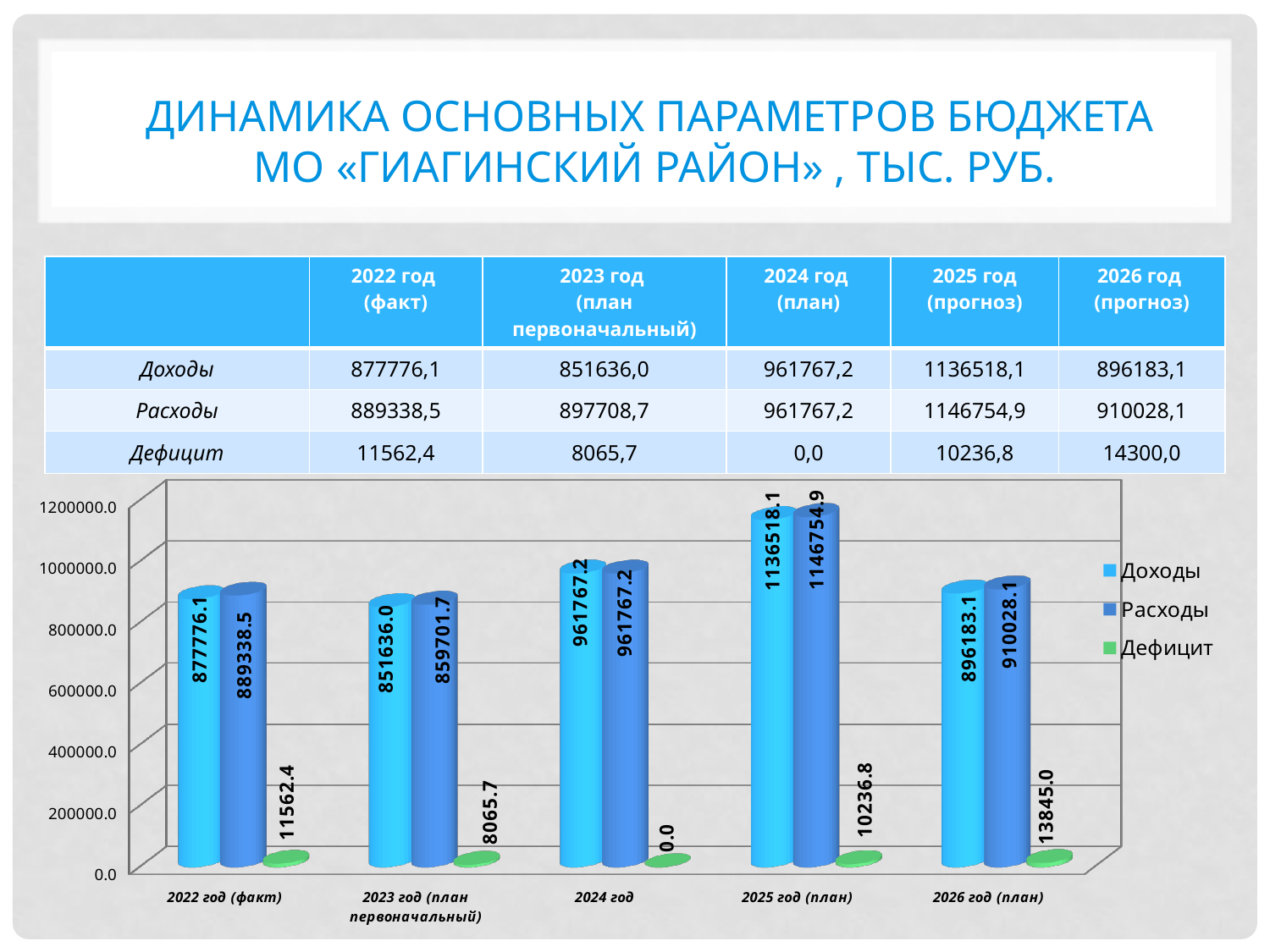
What is the value of Дефицит for 2024 год on the chart? 0.0 What type of chart is shown on the slide? bar chart Which year has the highest Доходы value on the chart? 2025 год (план) What is the difference between Расходы and Доходы for 2026 год (план) on the chart? 13845.0 Which year has the lowest Расходы value on the chart? 2023 год (план первоначальный) What is the value of Доходы for 2022 год (факт) on the chart? 877776.1 How many series does the chart legend list? 3 What is the value of Расходы for 2025 год (план) on the chart? 1146754.9 Is the Доходы value for 2025 год (план) greater or less than 1000000.0? greater What is the value of Дефицит for 2023 год (план первоначальный) on the chart? 8065.7 Which series is shown in green on the chart? Дефицит How many year categories are shown on the chart's x axis? 5